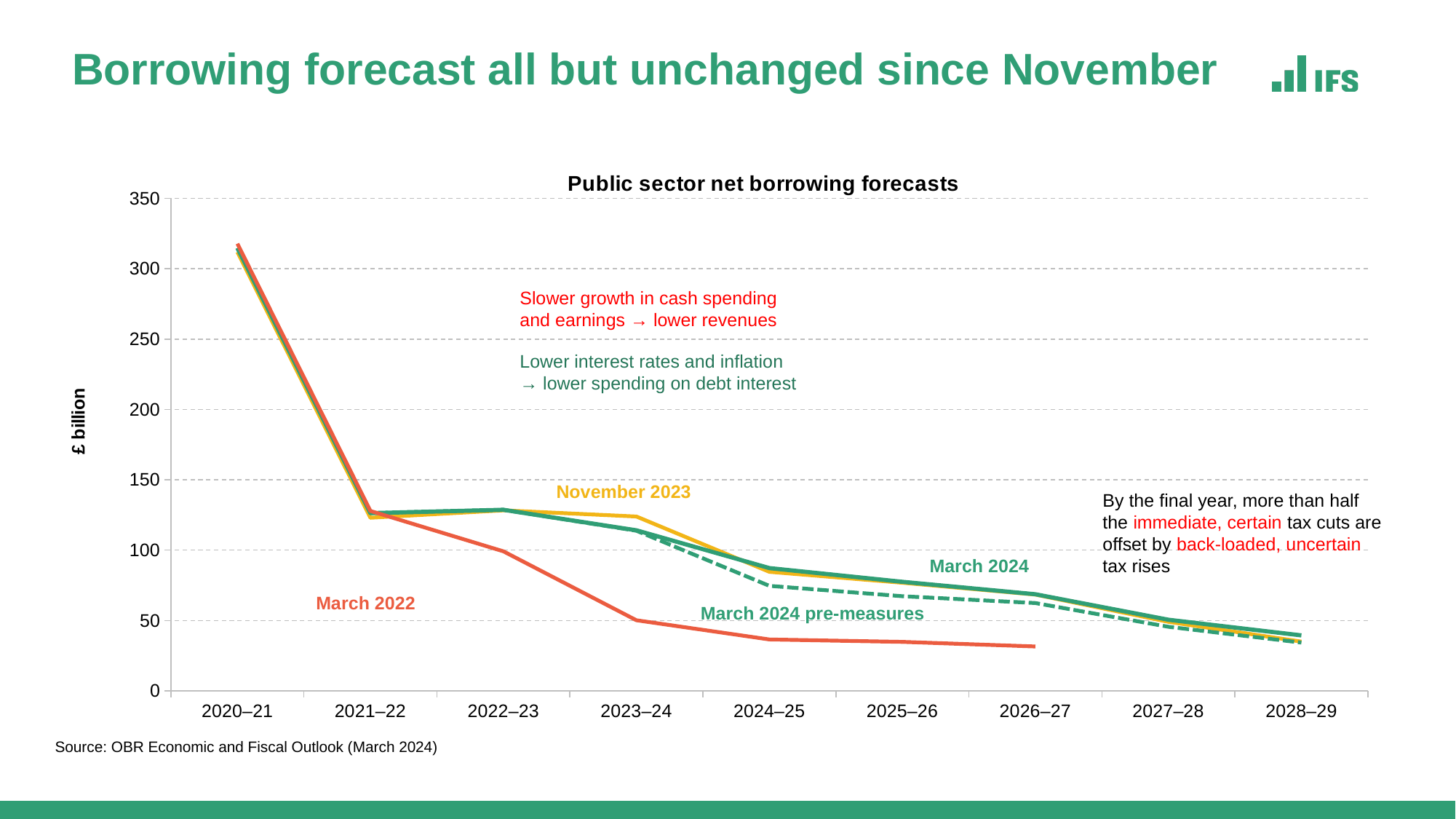
In which year is the March 2022 forecast highest? 2020–21 How many fiscal years are shown on the x axis of the chart? 9 Is the March 2022 forecast for 2020–21 greater or less than 300? greater Is the March 2024 pre-measures forecast for 2024–25 greater or less than 50? greater What is the label on the y axis of the chart? £ billion What kind of chart is shown on the slide? line chart Is the November 2023 forecast for 2023–24 greater or less than 100? greater What is the title of the chart? Public sector net borrowing forecasts Does the March 2022 forecast rise or fall from 2020–21 to 2026–27? fall How many forecast series are plotted on the chart? 4 In 2024–25, which is larger: the March 2022 forecast or the March 2024 forecast? March 2024